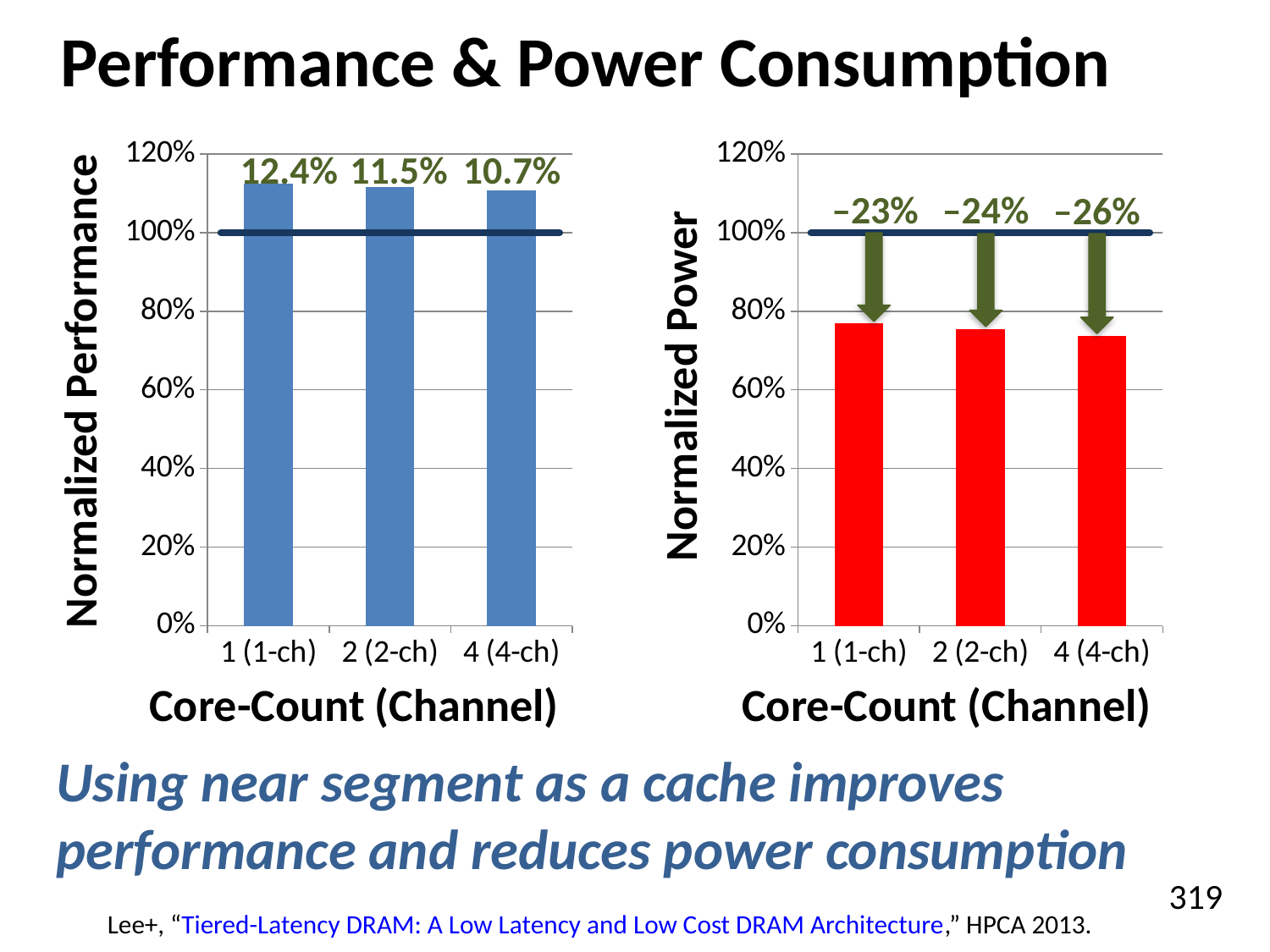
In the Normalized Power chart on the right, what power reduction is labeled for 4 (4-ch)? –26% In the Normalized Performance chart on the left, is the bar for 2 (2-ch) greater or less than 100%? greater In the Normalized Performance chart on the left, which core-count configuration has the largest labeled performance improvement? 1 (1-ch) In the Normalized Power chart on the right, do the bar heights rise or fall as the core count increases along the x axis? fall How many core-count configurations are shown on the x axis of the Normalized Power chart on the right? 3 In the Normalized Power chart on the right, what power reduction is labeled for 2 (2-ch)? –24% In the Normalized Power chart on the right, is the bar for 1 (1-ch) greater or less than 80%? less In the Normalized Performance chart on the left, what is the difference between the labeled improvements for 1 (1-ch) and 4 (4-ch)? 1.7% In the Normalized Performance chart on the left, what improvement is labeled above the bar for 4 (4-ch)? 10.7% In the Normalized Power chart on the right, which core-count configuration has the largest labeled power reduction? 4 (4-ch) In the Normalized Performance chart on the left, what performance improvement is labeled above the bar for 1 (1-ch)? 12.4% What kind of chart is the Normalized Performance chart on the left? bar chart